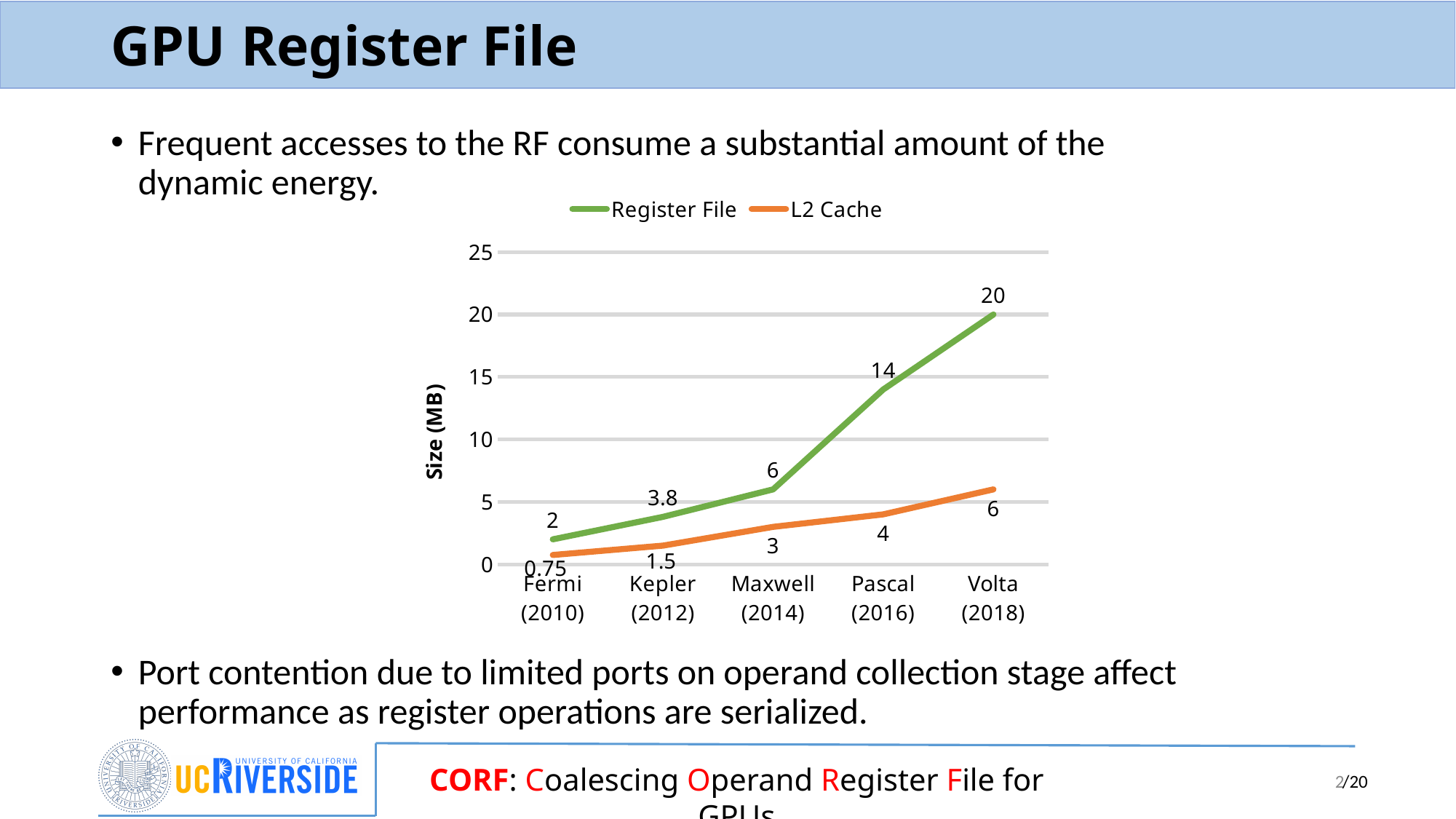
What is the Register File size for Volta (2018)? 20 Which GPU generation has the smallest L2 Cache size? Fermi (2010) Which GPU generation has the largest Register File size? Volta (2018) What is the difference between the Register File size and the L2 Cache size for Pascal (2016)? 10 What is the Register File size for Kepler (2012)? 3.8 Which is larger for Maxwell (2014): the Register File size or the L2 Cache size? Register File How many series does the legend list? 2 What is the L2 Cache size for Pascal (2016)? 4 What is the L2 Cache size for Fermi (2010)? 0.75 How many GPU generations are shown on the x axis? 5 What kind of chart is shown on the slide? Line chart Does the Register File size rise or fall from Fermi (2010) to Volta (2018)? Rise